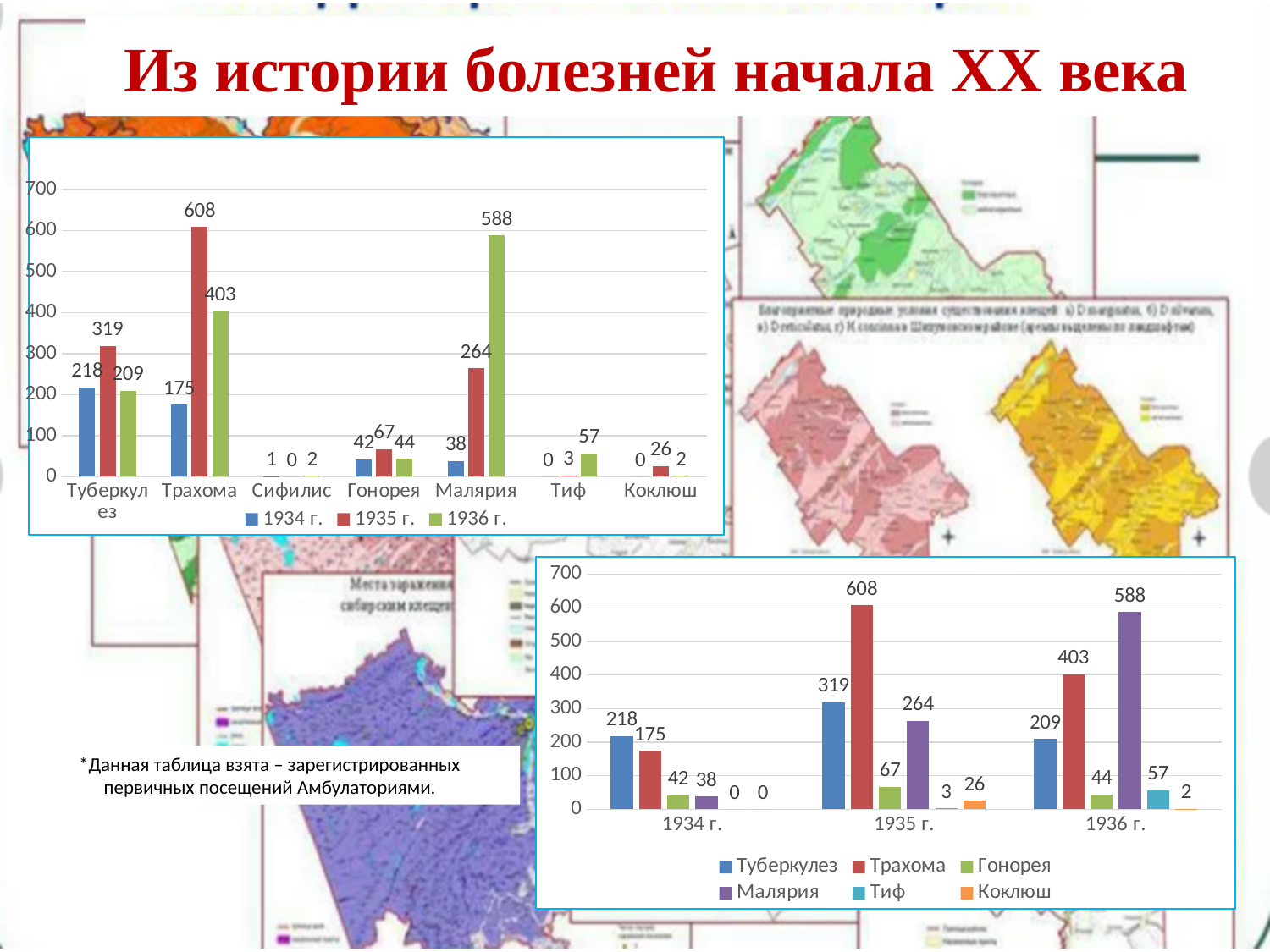
In the top-left chart, what is the difference between the 1935 г. and 1934 г. values for Туберкулез? 101 In the top-left chart, how many series does the legend list? 3 In the top-left chart, which category has the highest value for the 1934 г. series? Туберкулез In the top-left chart, which is larger: the 1936 г. value for Трахома or the 1936 г. value for Малярия? Малярия In the top-left chart, what is the value for Малярия in 1936 г.? 588 In the bottom-right chart, which series has the lowest value in 1936 г.? Коклюш In the top-left chart, what is the value for Трахома in 1935 г.? 608 What kind of chart is the bottom-right chart? Bar chart In the top-left chart, how many categories are shown on the x axis? 7 In the bottom-right chart, what is the value for Гонорея in 1935 г.? 67 In the bottom-right chart, how many series does the legend list? 6 In the bottom-right chart, does the value for Малярия rise or fall from 1934 г. to 1936 г.? Rise